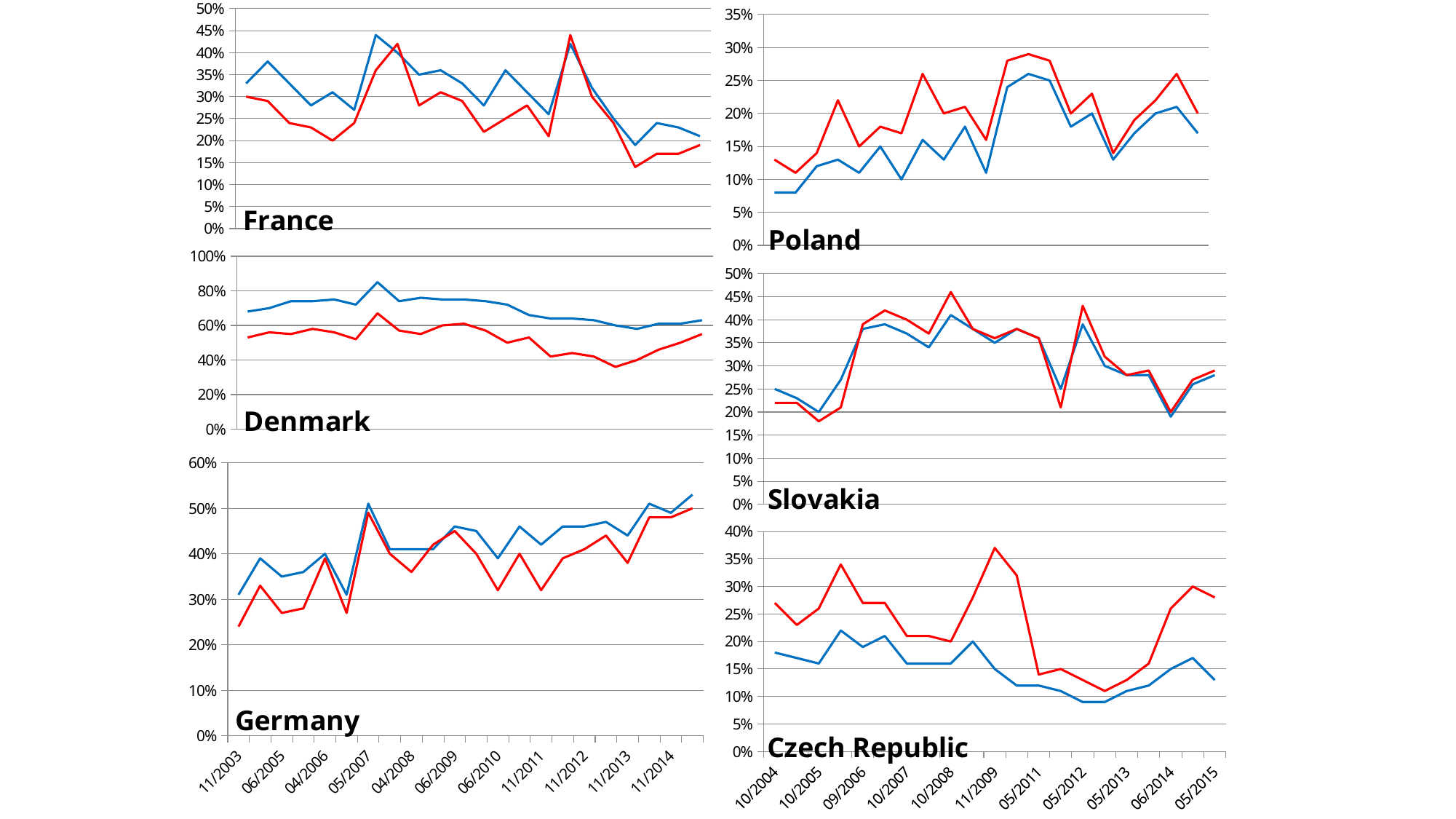
In the Denmark chart, does the blue line generally rise or fall between 05/2007 and 11/2013? fall In the Poland chart, is the blue line's value at 10/2004 greater or less than 10%? less In the Czech Republic chart, which line is higher throughout, the blue or the red? red How many lines are plotted in the Germany chart? 2 In the Czech Republic chart, at which date does the red line reach its highest value? 11/2009 In the France chart, is the blue line's value at 05/2007 greater or less than 40%? greater How many charts are on the slide? 6 In the Czech Republic chart, is the peak of the red line greater or less than 35%? greater What is the maximum value shown on the y-axis of the Denmark chart? 100% In the Denmark chart, which line is higher throughout, the blue or the red? blue What kind of chart is the France chart? line chart